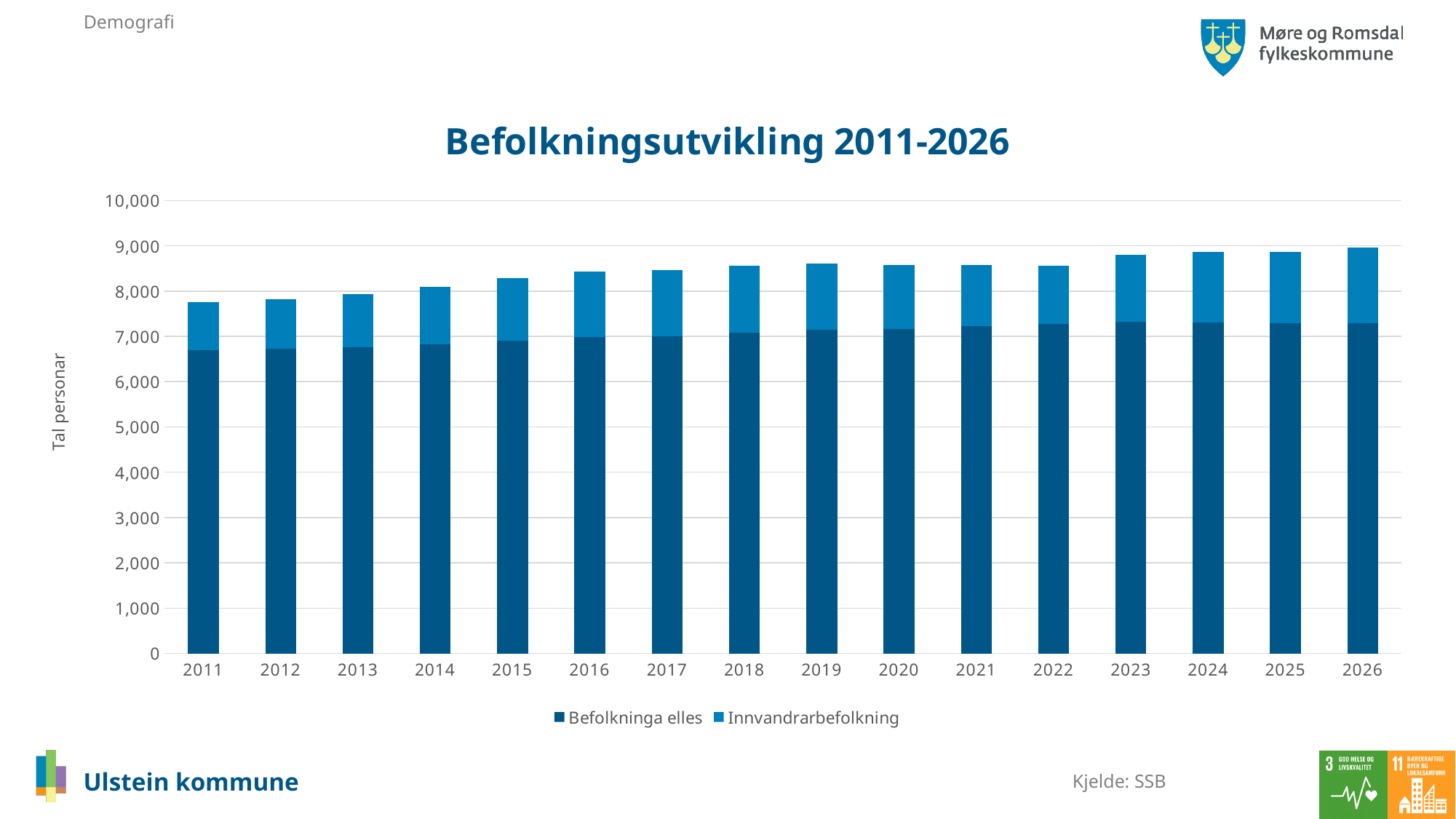
What is the label on the vertical axis of the chart? Tal personar Is the total bar for 2015 greater or less than 8,000? greater Is the total bar for 2011 greater or less than 8,000? less Which year has the lowest total bar in the chart? 2011 Do the total bars generally rise or fall from 2011 to 2026? rise What is the title of the chart? Befolkningsutvikling 2011-2026 How many series does the legend list? 2 Is the 'Befolkninga elles' value for 2011 greater or less than 7,000? less What kind of chart is shown on the slide? Stacked bar chart Which total bar is larger, 2011 or 2026? 2026 How many years are shown on the x axis of the chart? 16